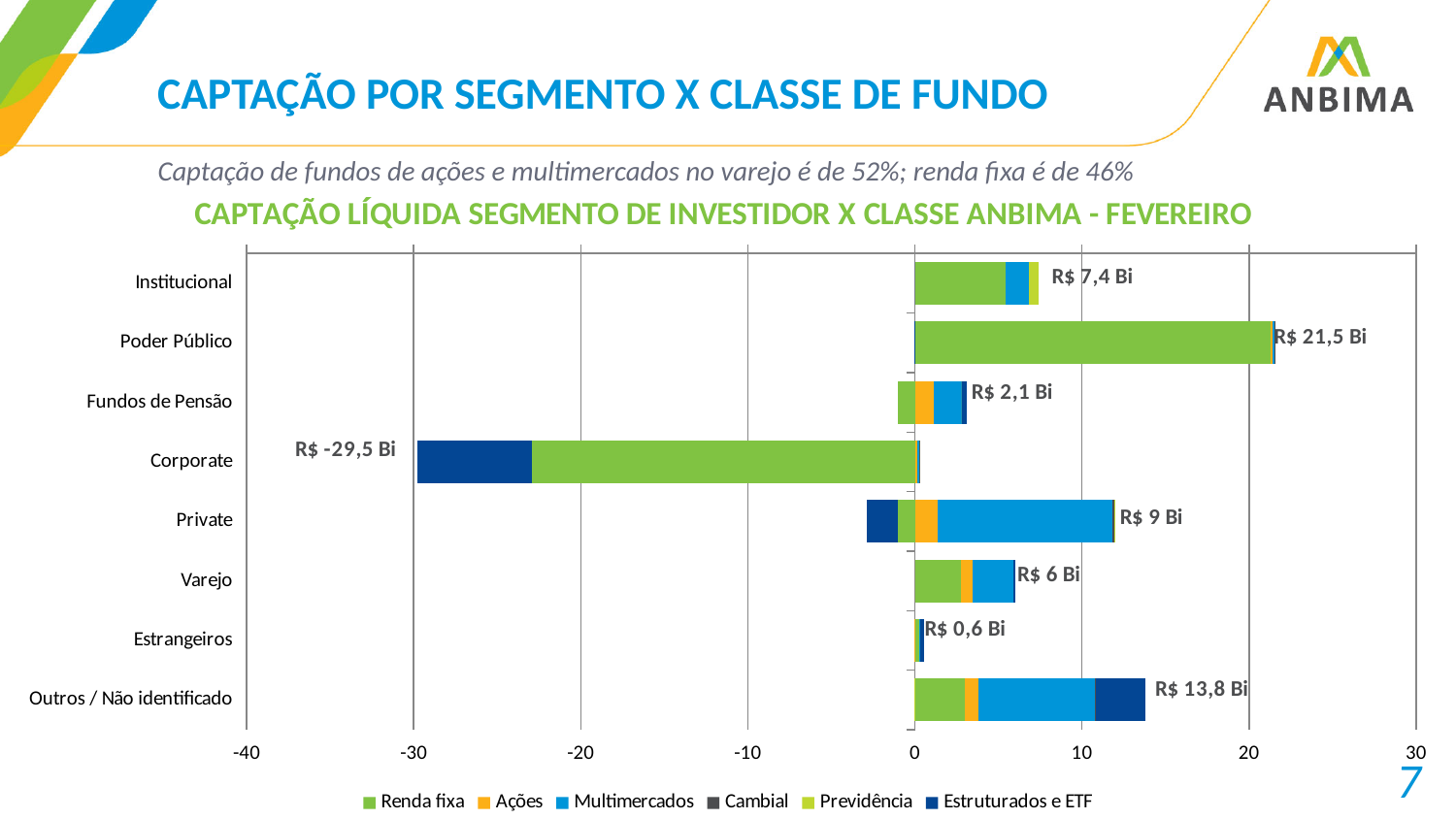
How many series does the legend list? 6 What is the difference between the total for Poder Público and the total for Outros / Não identificado? R$ 7,7 Bi What kind of chart is shown on the slide? Stacked bar chart What is the total net funding labelled for Outros / Não identificado? R$ 13,8 Bi What is the total net funding labelled for Corporate? R$ -29,5 Bi Which investor segment has the highest total net funding? Poder Público Which investor segment has the lowest total net funding? Corporate How many investor segments are shown on the chart? 8 Which has a larger total net funding, Institucional or Varejo? Institucional What is the total net funding labelled for Poder Público? R$ 21,5 Bi Is the Renda fixa value for Poder Público greater or less than 20? greater What is the difference between the total for Private and the total for Varejo? R$ 3 Bi